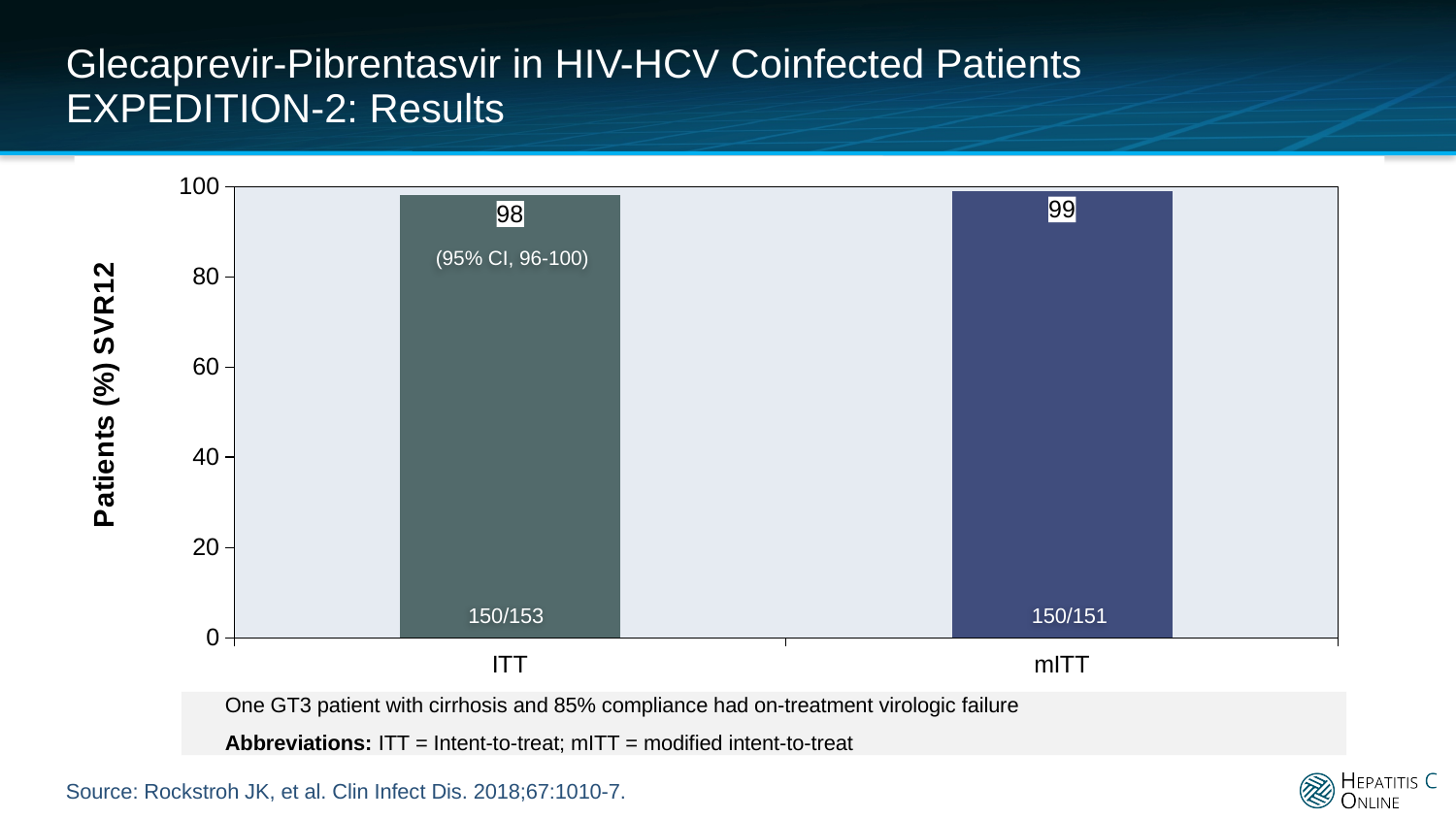
What kind of chart is shown on the slide? Bar chart What does the abbreviation mITT stand for, according to the slide? Modified intent-to-treat How many categories are plotted on the chart? 2 Which group has the higher SVR12 rate, ITT or mITT? mITT What is the difference in SVR12 rate (%) between the mITT and ITT groups? 1 Is the value for ITT greater or less than 80? greater How many patients achieved SVR12 out of the total in the ITT group, as shown on the bar? 150/153 What is the SVR12 rate (%) for the mITT group? 99 What is the 95% confidence interval shown for the ITT group? 96-100 What is the SVR12 rate (%) for the ITT group? 98 How many patients achieved SVR12 out of the total in the mITT group, as shown on the bar? 150/151 What is the label of the y-axis? Patients (%) SVR12